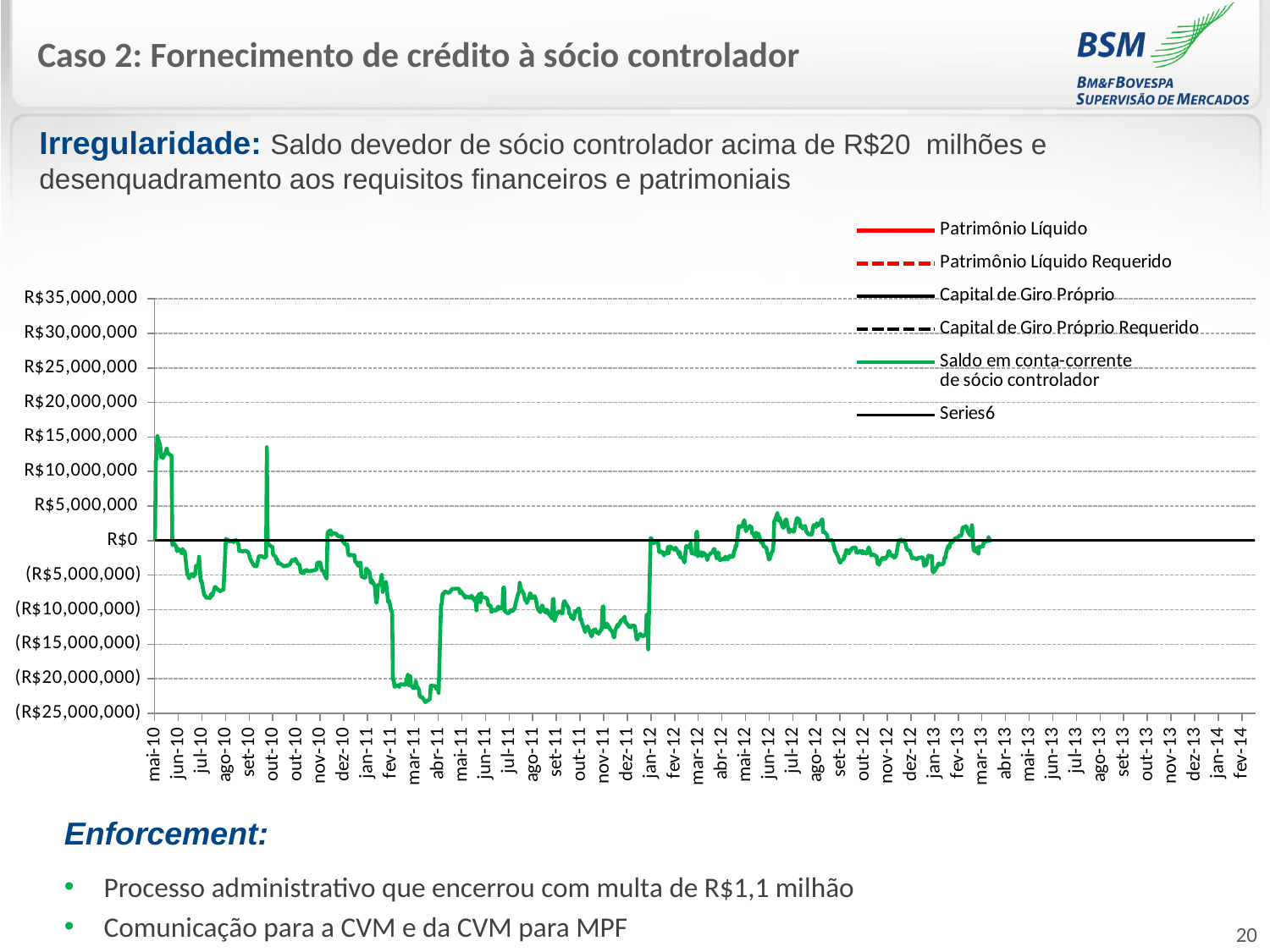
What colour is the line for 'Saldo em conta-corrente de sócio controlador' in the legend? green What is the highest value shown on the chart's y axis? R$35,000,000 What is the last month label on the chart's x axis? fev-14 Does the 'Saldo em conta-corrente de sócio controlador' line rise or fall between mai-11 and dez-11? fall What kind of chart is shown on the slide? line chart Is the value of 'Saldo em conta-corrente de sócio controlador' around jul-12 greater or less than R$5,000,000? less How many series does the chart legend list? 6 Is the peak of 'Saldo em conta-corrente de sócio controlador' around out-10 greater or less than R$10,000,000? greater What is the first month label on the chart's x axis? mai-10 Is the value of 'Saldo em conta-corrente de sócio controlador' around dez-11 greater or less than (R$10,000,000)? less